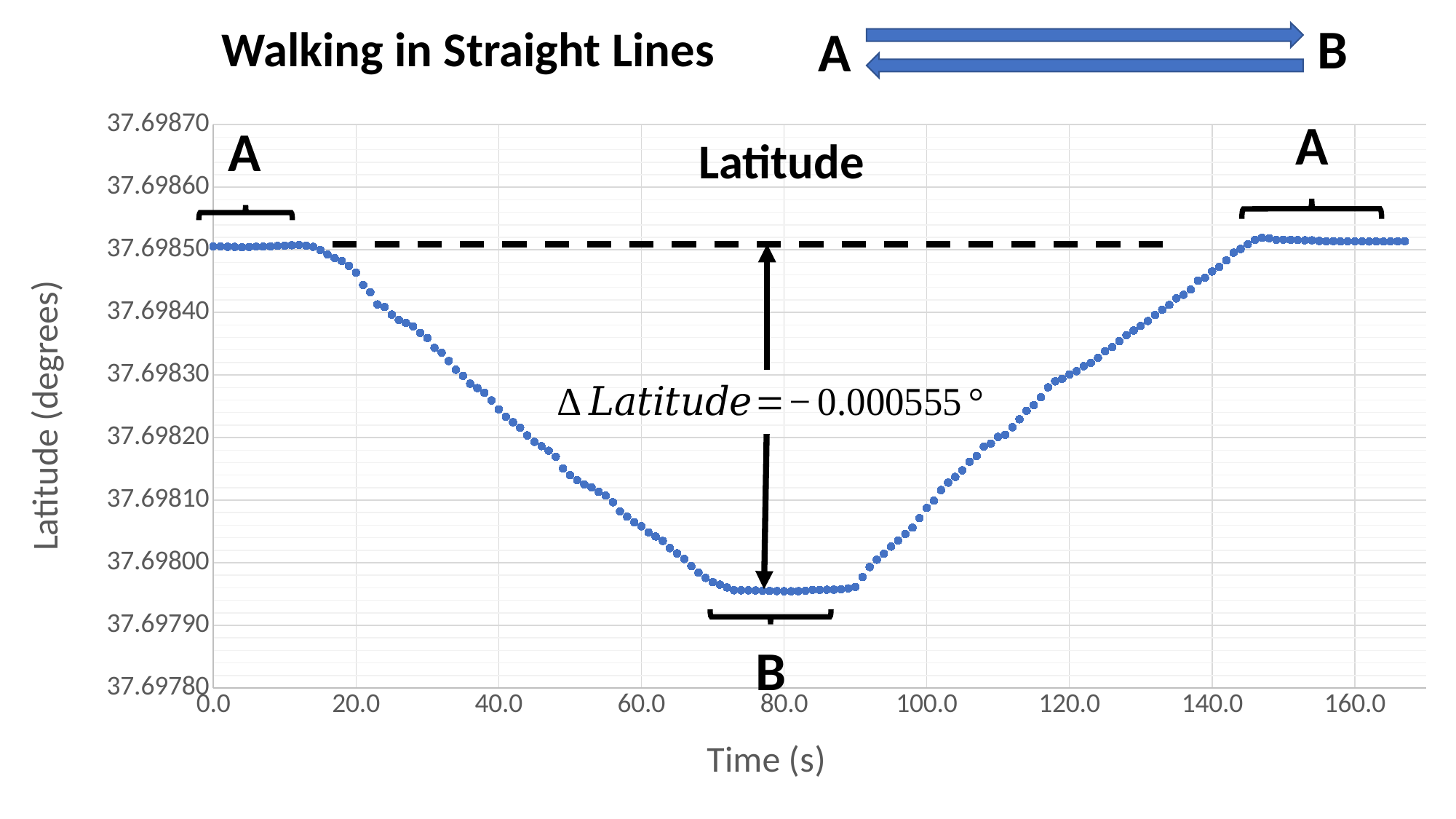
What is the title of the chart? Latitude Which is larger, the latitude at 100.0 s or the latitude at 140.0 s? 140.0 s Which is larger, the latitude at 20.0 s or the latitude at 60.0 s? 20.0 s Is the latitude value at 160.0 s greater or less than 37.69840? greater Is the latitude value at 80.0 s greater or less than 37.69800? less What kind of chart is shown on the slide? scatter chart Is the latitude value at 0.0 s greater or less than 37.69840? greater What is the label of the x axis of the chart? Time (s) Do the latitude values rise or fall between 20.0 s and 70.0 s? fall Do the latitude values rise or fall between 90.0 s and 140.0 s? rise What change in latitude is annotated on the chart? −0.000555°